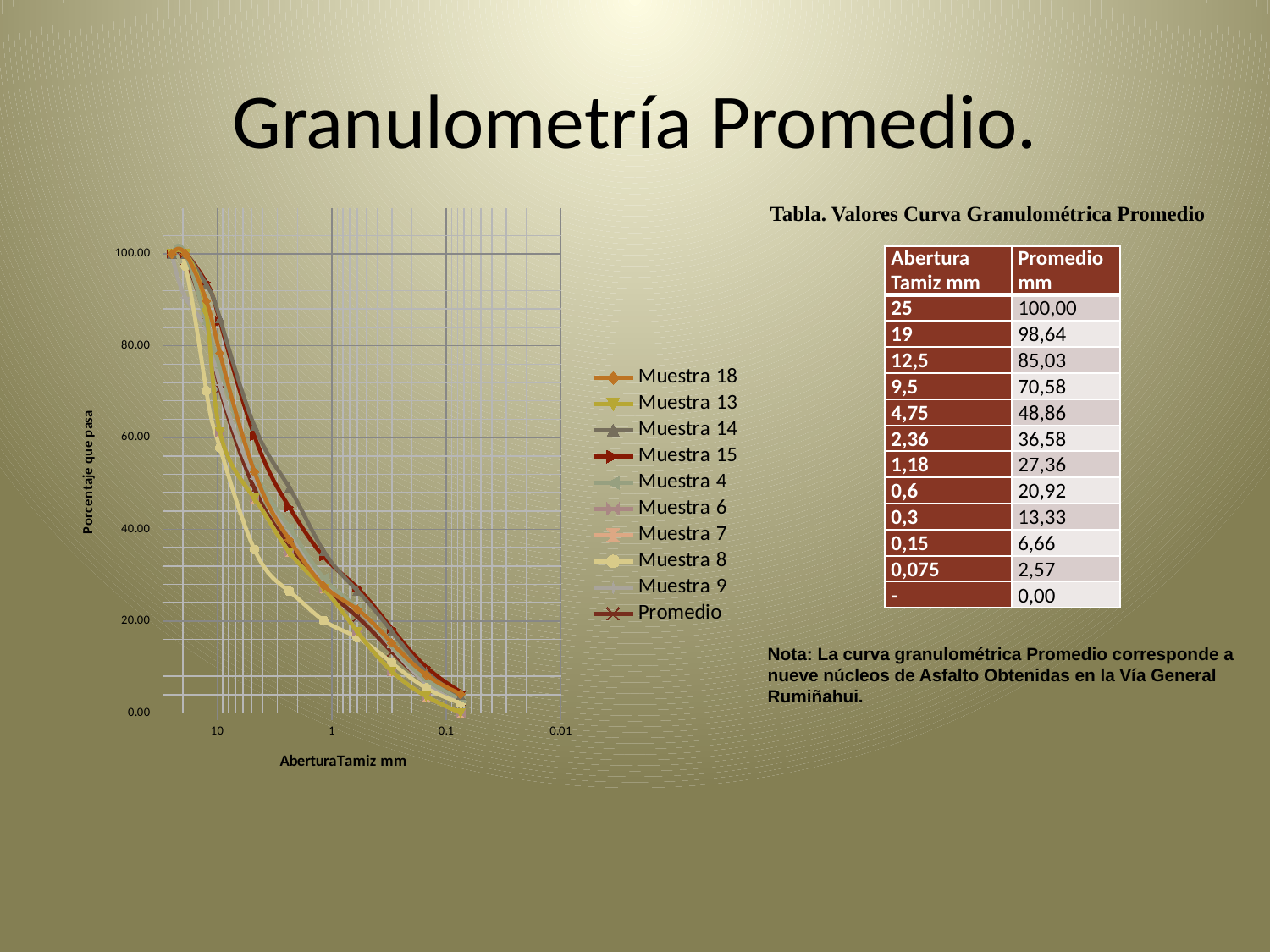
What is the label of the chart's vertical axis? Porcentaje que pasa According to the table, what is the Promedio value at a sieve opening of 4,75 mm? 48,86 Do the plotted values rise or fall as you move from left to right along the x axis (from 10 mm toward 0.01 mm)? fall Is the value of the Promedio curve at a sieve opening of 1 mm greater or less than 40? less According to the table, is the Promedio value at 2,36 mm larger or smaller than at 1,18 mm? larger According to the table, which sieve opening has the highest Promedio value? 25 According to the table, what is the difference between the Promedio values at 12,5 mm and 9,5 mm? 14,45 What kind of chart is shown on the slide? line chart What is the label of the chart's horizontal axis? AberturaTamiz mm How many series does the chart legend list? 10 According to the table, what is the Promedio value at a sieve opening of 19 mm? 98,64 According to the table, what is the Promedio value at a sieve opening of 0,3 mm? 13,33